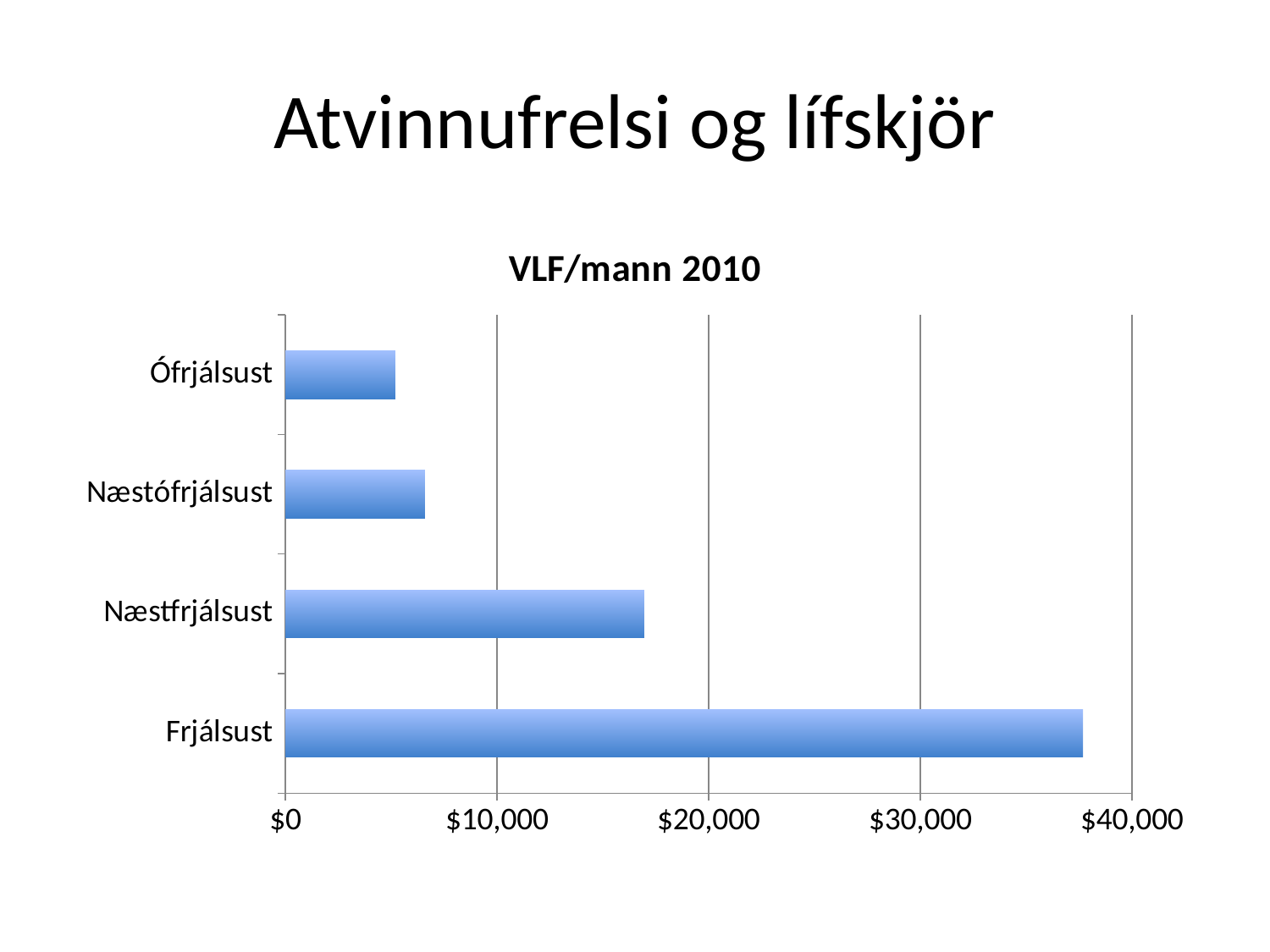
What kind of chart is shown on the slide? bar chart Is the value for Ófrjálsust greater or less than $10,000? less Is the value for Næstfrjálsust greater or less than $20,000? less What is the title of the chart? VLF/mann 2010 Which has a larger value, Frjálsust or Næstfrjálsust? Frjálsust Is the value for Frjálsust greater or less than $30,000? greater Which has a larger value, Næstófrjálsust or Ófrjálsust? Næstófrjálsust How many categories are shown in the chart? 4 Which category has the highest value? Frjálsust Which category has the lowest value? Ófrjálsust